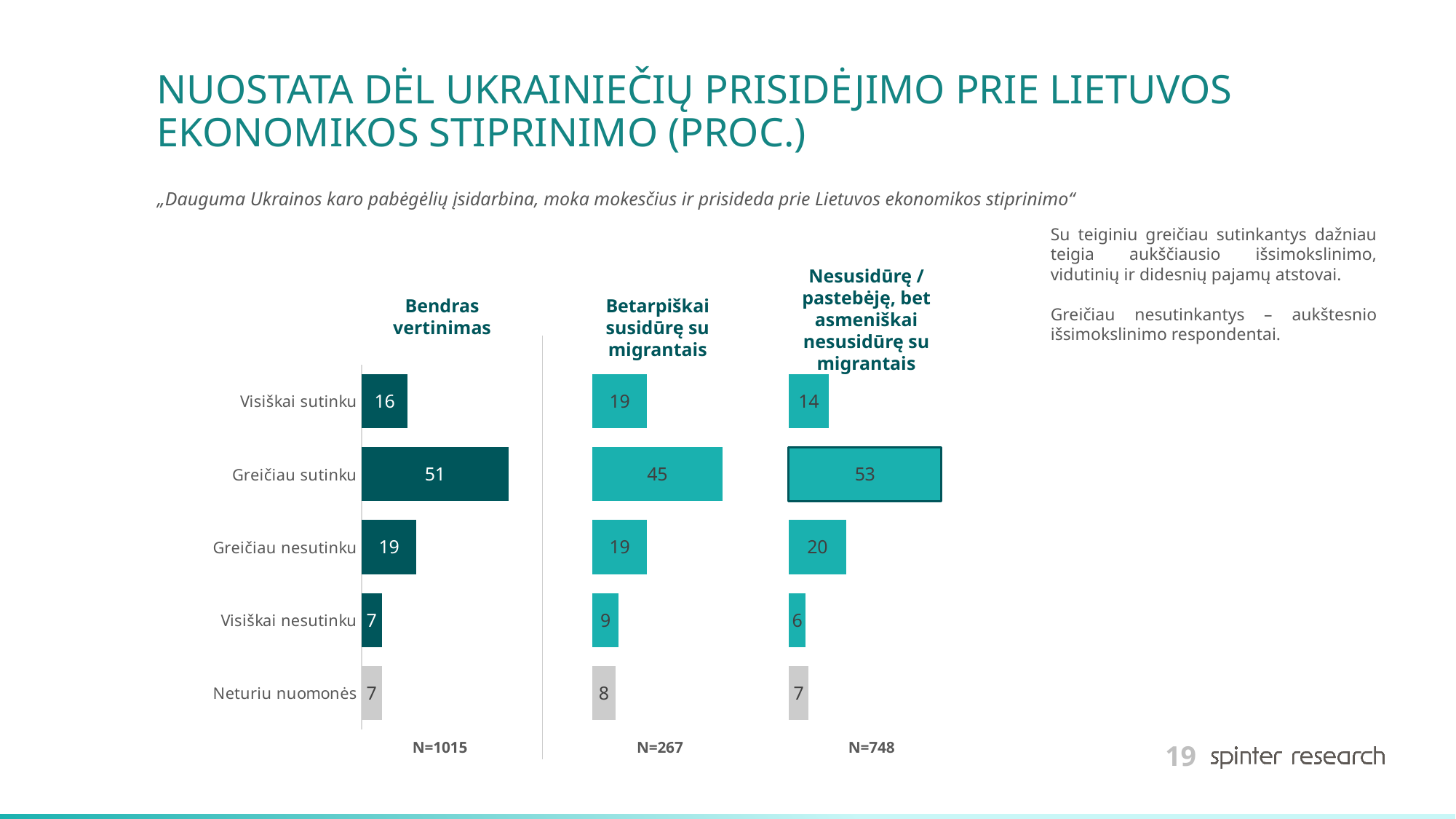
Which is larger for "Greičiau sutinku": the value in the "Betarpiškai susidūrę su migrantais" chart or the value in the "Nesusidūrę / pastebėję, bet asmeniškai nesusidūrę su migrantais" chart? Nesusidūrę / pastebėję, bet asmeniškai nesusidūrę su migrantais How many categories are shown in the "Bendras vertinimas" chart? 5 What is the sample size (N) shown under the "Betarpiškai susidūrę su migrantais" chart? N=267 What kind of chart is the "Bendras vertinimas" chart? Bar chart In the "Nesusidūrę / pastebėję, bet asmeniškai nesusidūrę su migrantais" chart, what is the value for "Greičiau nesutinku"? 20 In the "Bendras vertinimas" chart, which category has the highest value? Greičiau sutinku In the "Nesusidūrę / pastebėję, bet asmeniškai nesusidūrę su migrantais" chart, what is the value for "Neturiu nuomonės"? 7 In the "Betarpiškai susidūrę su migrantais" chart, what is the difference between "Greičiau sutinku" and "Visiškai sutinku"? 26 In the "Bendras vertinimas" chart, what is the value for "Greičiau sutinku"? 51 In the "Nesusidūrę / pastebėję, bet asmeniškai nesusidūrę su migrantais" chart, which category has the lowest value? Visiškai nesutinku In the "Bendras vertinimas" chart, what is the difference between "Greičiau sutinku" and "Greičiau nesutinku"? 32 In the "Betarpiškai susidūrę su migrantais" chart, what is the value for "Visiškai sutinku"? 19